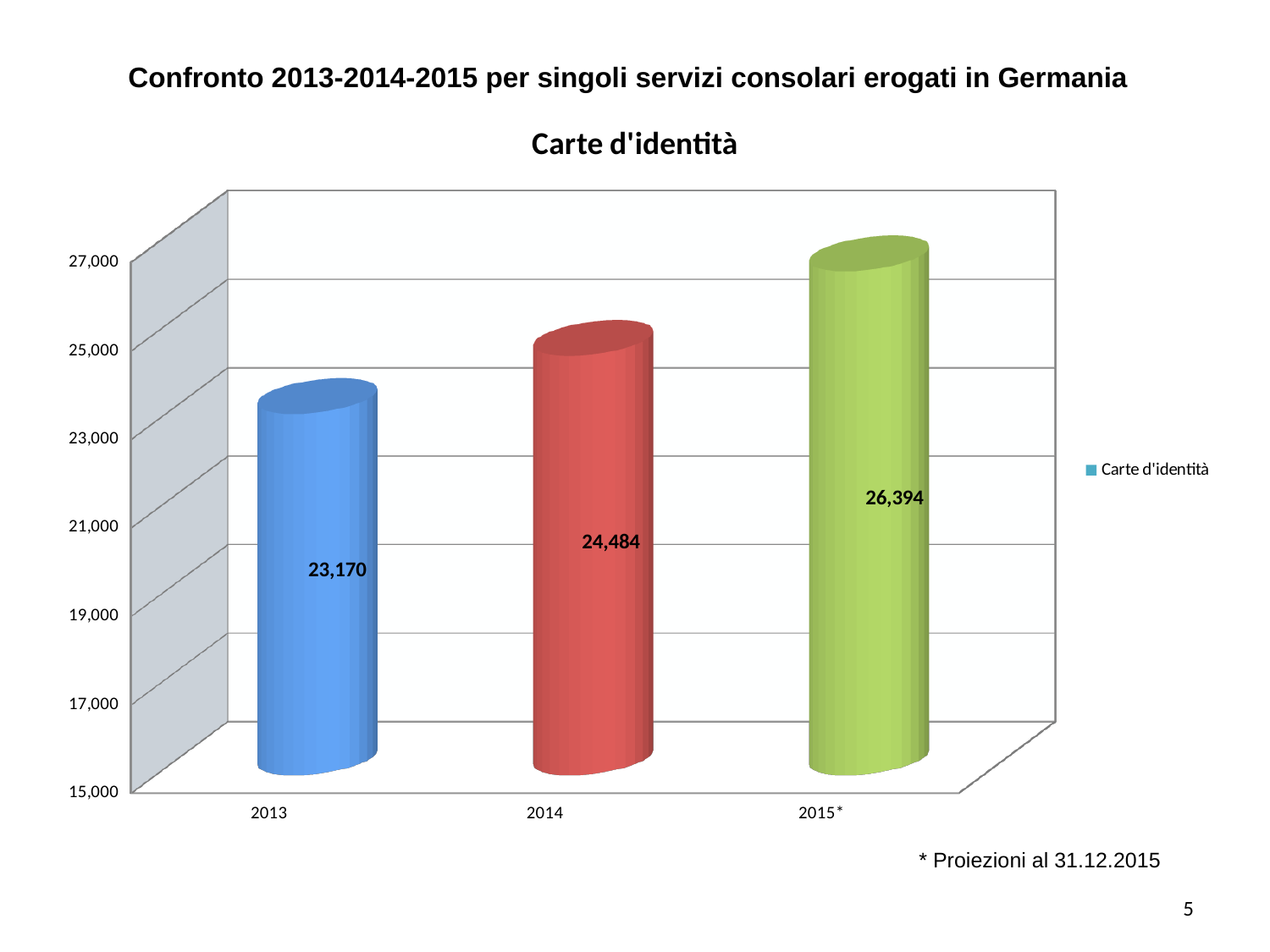
Which year has the highest value in the Carte d'identità chart? 2015* Is the value for 2014 in the Carte d'identità chart greater or less than 25,000? less How many years are shown on the x axis of the Carte d'identità chart? 3 What is the difference between the 2015* and 2013 values in the Carte d'identità chart? 3,224 What is the value for 2013 in the Carte d'identità chart? 23,170 Do the values in the Carte d'identità chart rise or fall from 2013 to 2015*? rise What kind of chart is the Carte d'identità chart? bar chart Which year has the lowest value in the Carte d'identità chart? 2013 What is the value for 2015* in the Carte d'identità chart? 26,394 What is the value for 2014 in the Carte d'identità chart? 24,484 What is the difference between the 2014 and 2013 values in the Carte d'identità chart? 1,314 Which is larger in the Carte d'identità chart, the value for 2014 or the value for 2015*? 2015*